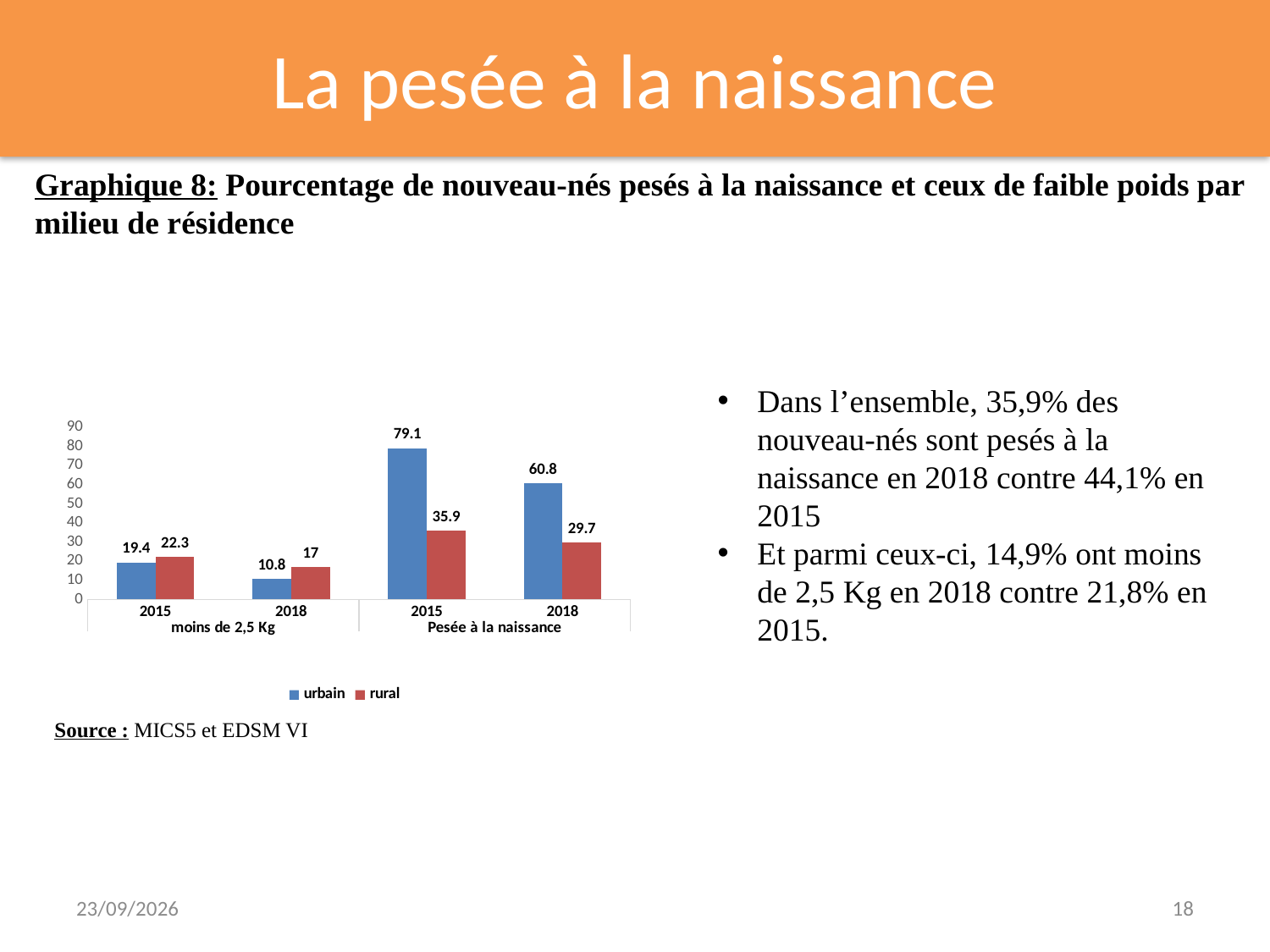
How many series does the legend list? 2 What is the rural value for Pesée à la naissance in 2018? 29.7 What is the difference between the urbain and rural values for Pesée à la naissance in 2015? 43.2 What is the urbain value for Pesée à la naissance in 2015? 79.1 Which bar has the highest value in the chart? urbain, Pesée à la naissance 2015 For moins de 2,5 Kg in 2015, which is larger, the urbain or the rural value? rural What is the difference between the urbain values for Pesée à la naissance in 2015 and 2018? 18.3 Which bar has the lowest value in the chart? urbain, moins de 2,5 Kg 2018 What kind of chart is shown on the slide? bar chart What colour represents the rural series in the chart? red Does the urbain value for Pesée à la naissance rise or fall from 2015 to 2018? fall What is the rural value for moins de 2,5 Kg in 2018? 17